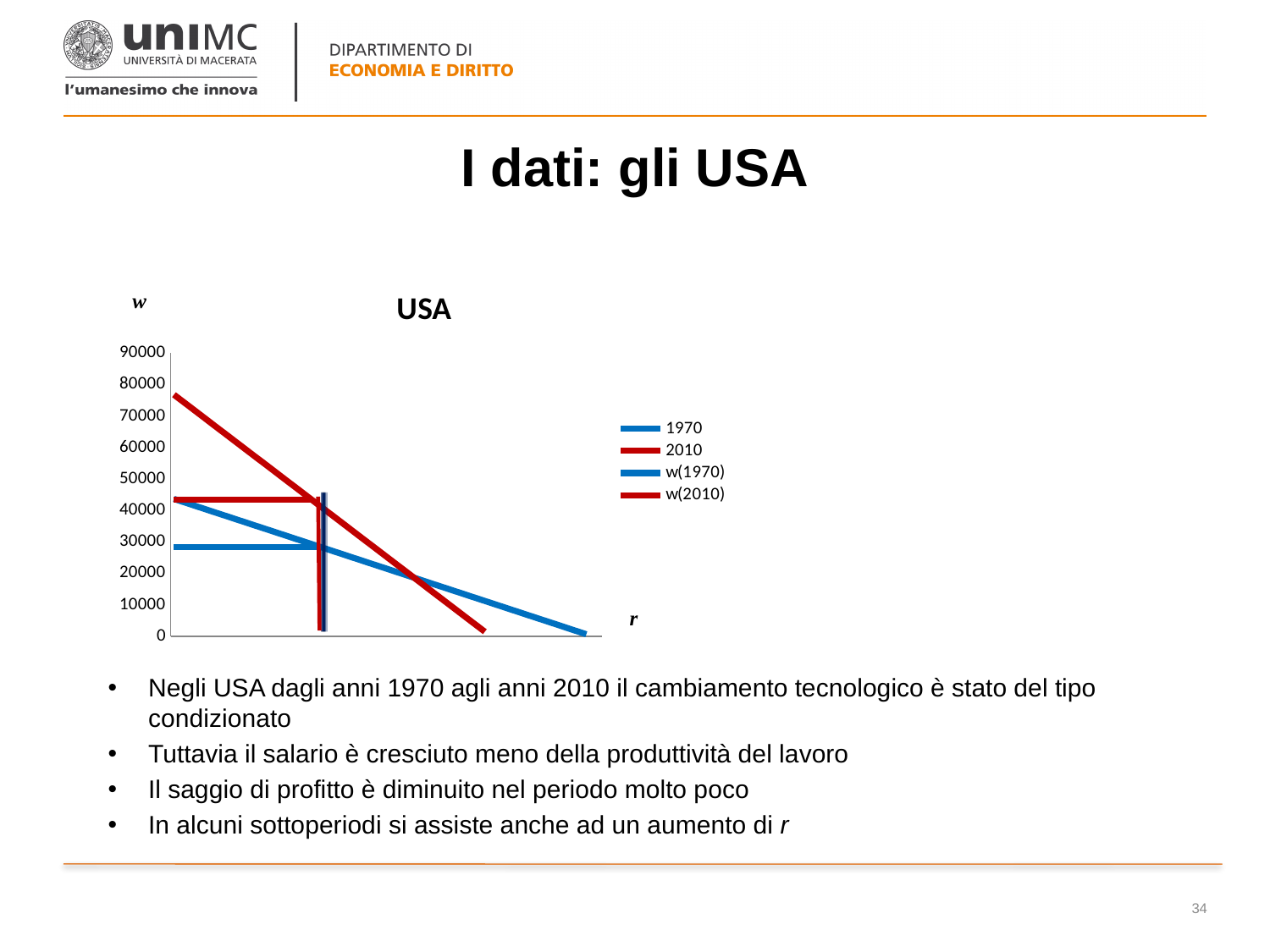
Is the value of the w(2010) line greater or less than 40000? greater What is the highest value shown on the vertical axis of the chart? 90000 Which line starts higher at r = 0, 1970 or 2010? 2010 What colour is the 2010 series in the chart? red Is the value of the 1970 line at r = 0 greater or less than 50000? less What kind of chart is shown on the slide? line chart Is the value of the w(1970) line greater or less than 40000? less Which horizontal line is higher, w(1970) or w(2010)? w(2010) Does the 2010 line rise or fall as r increases? fall How many series does the legend of the USA chart list? 4 What is the title of the chart? USA